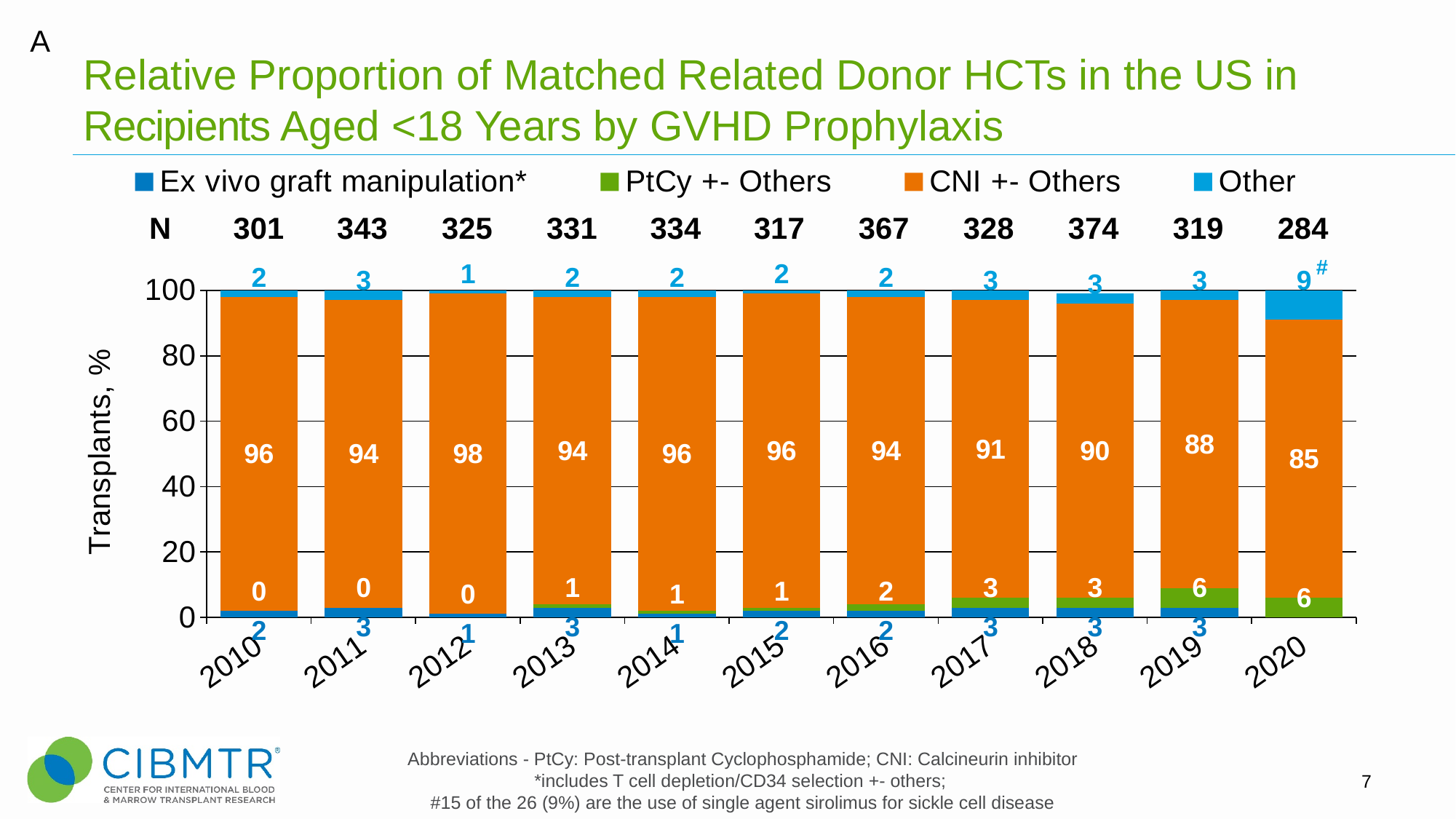
What percentage of transplants used PtCy +- Others in 2019? 6 Which year has the lowest percentage for CNI +- Others? 2020 What percentage of transplants fell in the Other category in 2020? 9 How many years are shown on the x axis? 11 What percentage of transplants used CNI +- Others in 2020? 85 What is the difference in the CNI +- Others percentage between 2010 and 2020? 11 Does the CNI +- Others percentage rise or fall from 2016 to 2020? fall Which year has the largest N? 2018 How many series does the legend list? 4 What is the N value shown for 2018? 374 Which year has the larger PtCy +- Others percentage, 2013 or 2017? 2017 Which year has the highest percentage for CNI +- Others? 2012